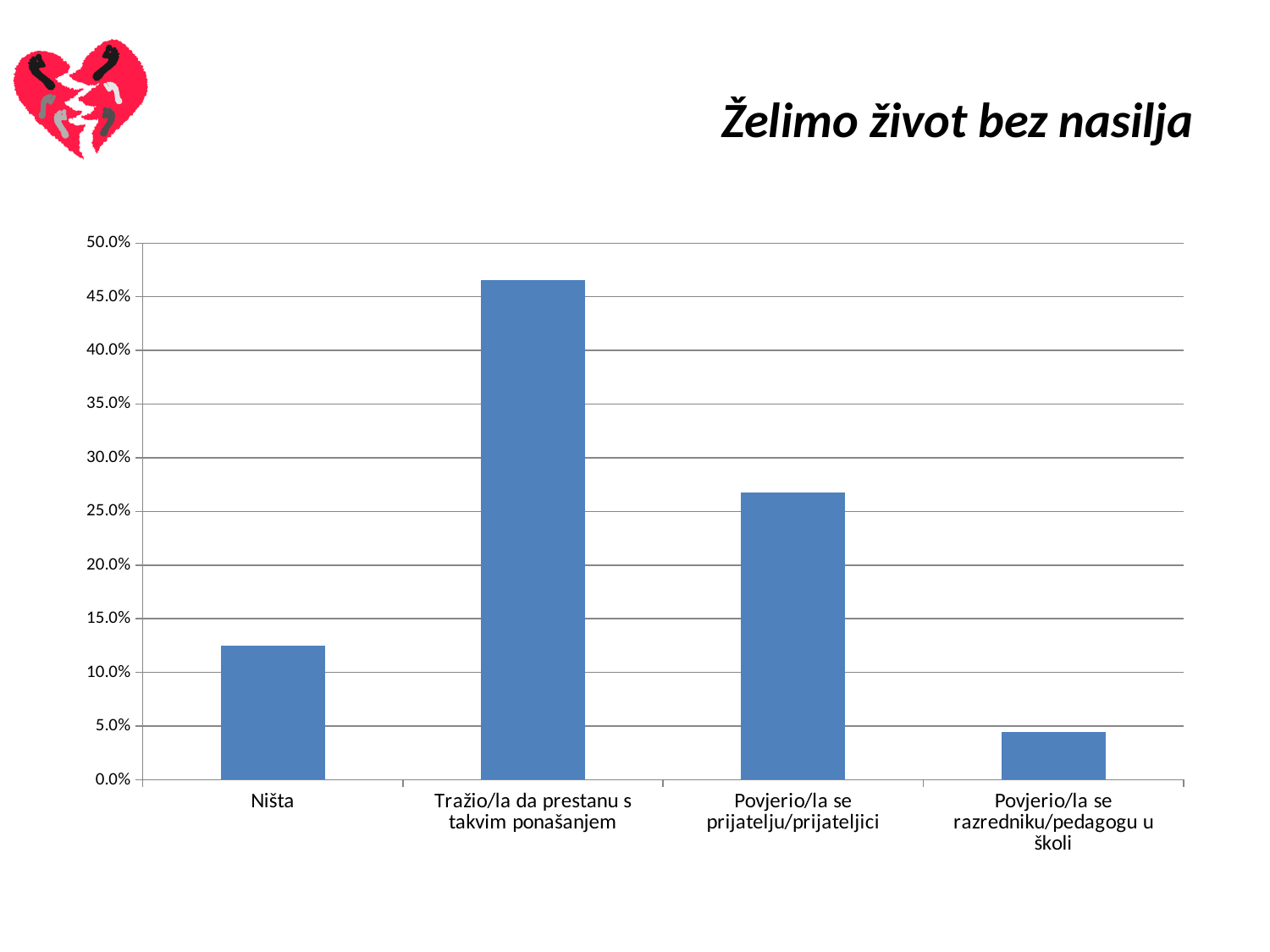
Which category has the lowest value in the chart? Povjerio/la se razredniku/pedagogu u školi What is the maximum value shown on the y axis of the chart? 50.0% What is the title shown at the top of the slide? Želimo život bez nasilja Is the value for Ništa greater or less than 10.0%? greater Is the value for Tražio/la da prestanu s takvim ponašanjem greater or less than 45.0%? greater Is the value for Povjerio/la se prijatelju/prijateljici greater or less than 30.0%? less What kind of chart is shown on the slide? bar chart How many categories are shown on the x axis of the chart? 4 Which is larger, the value for Ništa or the value for Povjerio/la se razredniku/pedagogu u školi? Ništa Which is larger, the value for Ništa or the value for Povjerio/la se prijatelju/prijateljici? Povjerio/la se prijatelju/prijateljici Which category has the highest value in the chart? Tražio/la da prestanu s takvim ponašanjem